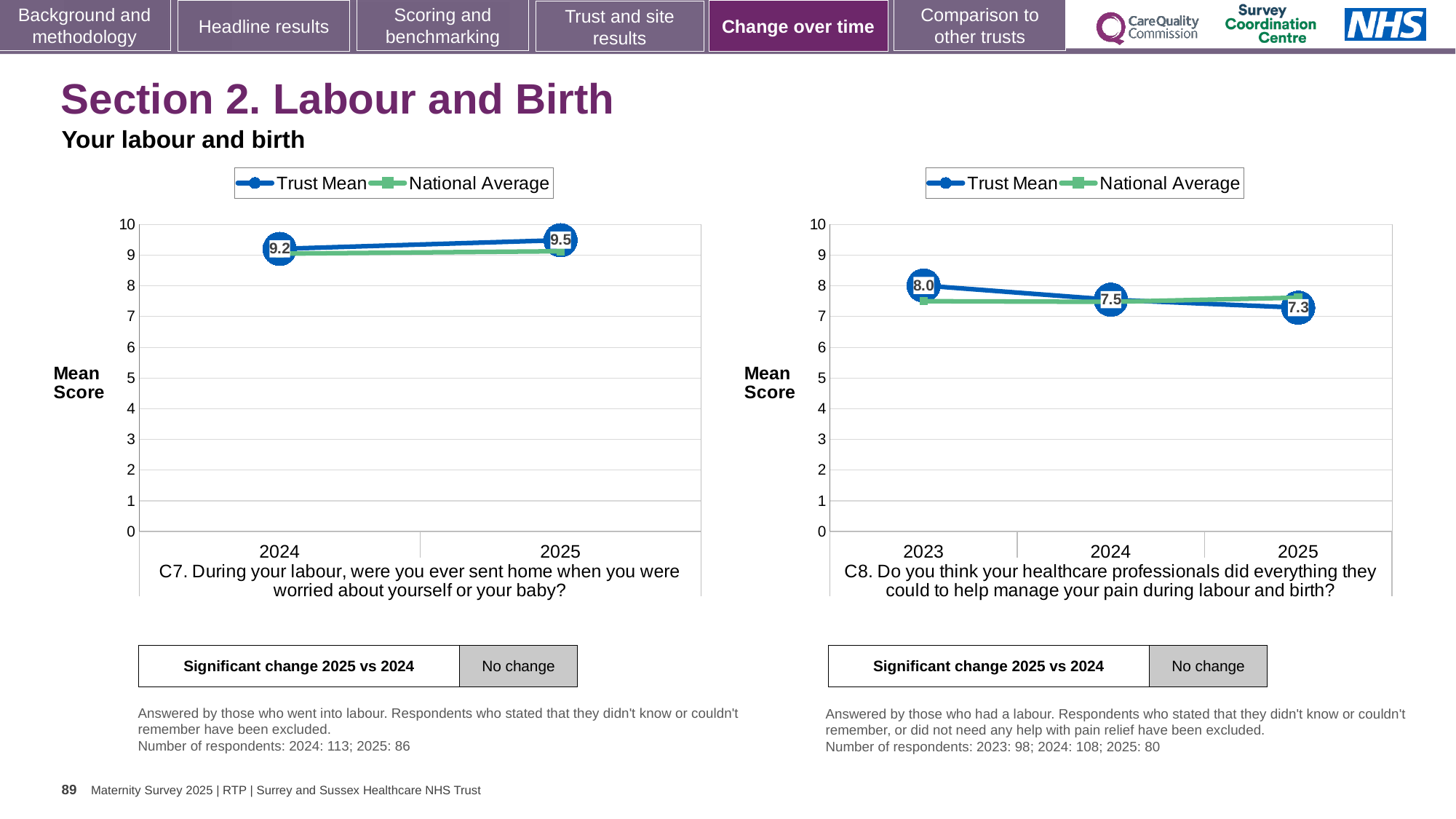
In the left chart (C7), does the Trust Mean rise or fall from 2024 to 2025? rise In the right chart (C8), what is the difference between the Trust Mean in 2023 and 2025? 0.7 In the left chart (C7), by how much did the Trust Mean change from 2024 to 2025? 0.3 In the right chart (C8), what is the Trust Mean for 2023? 8.0 In the left chart (C7), what is the Trust Mean for 2024? 9.2 What type of chart is used for the C8 question on the right? line chart In the right chart (C8), which year has the lowest Trust Mean? 2025 In the right chart (C8), what is the Trust Mean for 2025? 7.3 How many years are plotted on the x axis of the right chart (C8)? 3 In the right chart (C8), does the Trust Mean rise or fall across the years shown? fall How many series does the legend of the left chart (C7) list? 2 In the left chart (C7), what is the Trust Mean for 2025? 9.5